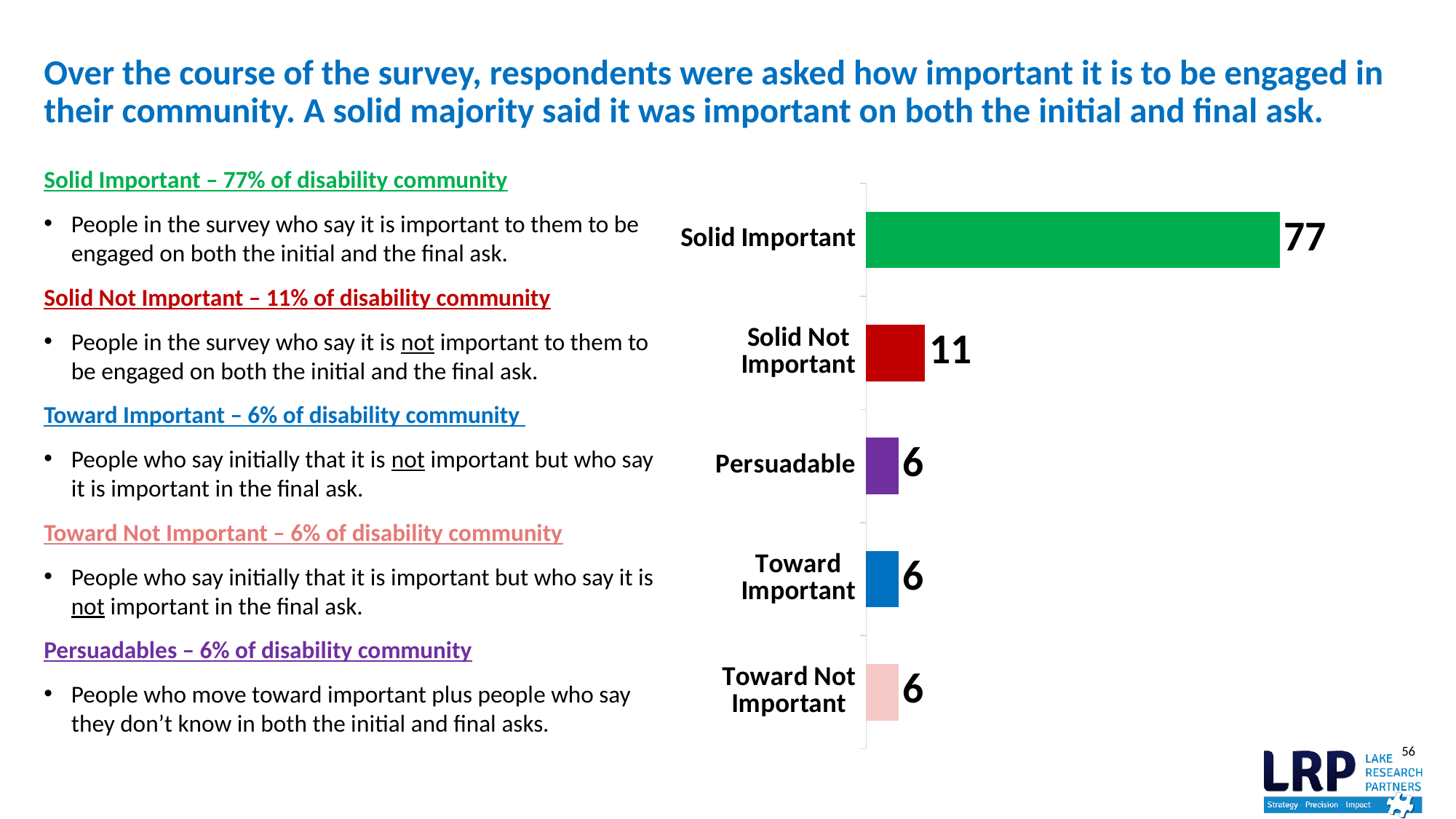
What colour is the bar for Solid Important? Green What is the value for Solid Not Important? 11 What is the difference between the values for Solid Important and Solid Not Important? 66 What is the value for Toward Not Important? 6 What is the value for Solid Important? 77 What is the difference between the values for Solid Not Important and Toward Important? 5 Which is larger, the value for Solid Not Important or the value for Persuadable? Solid Not Important Which category has the highest value? Solid Important What is the value for Persuadable? 6 What colour is the bar for Persuadable? Purple What kind of chart is shown on the slide? Bar chart How many categories are shown in the chart? 5